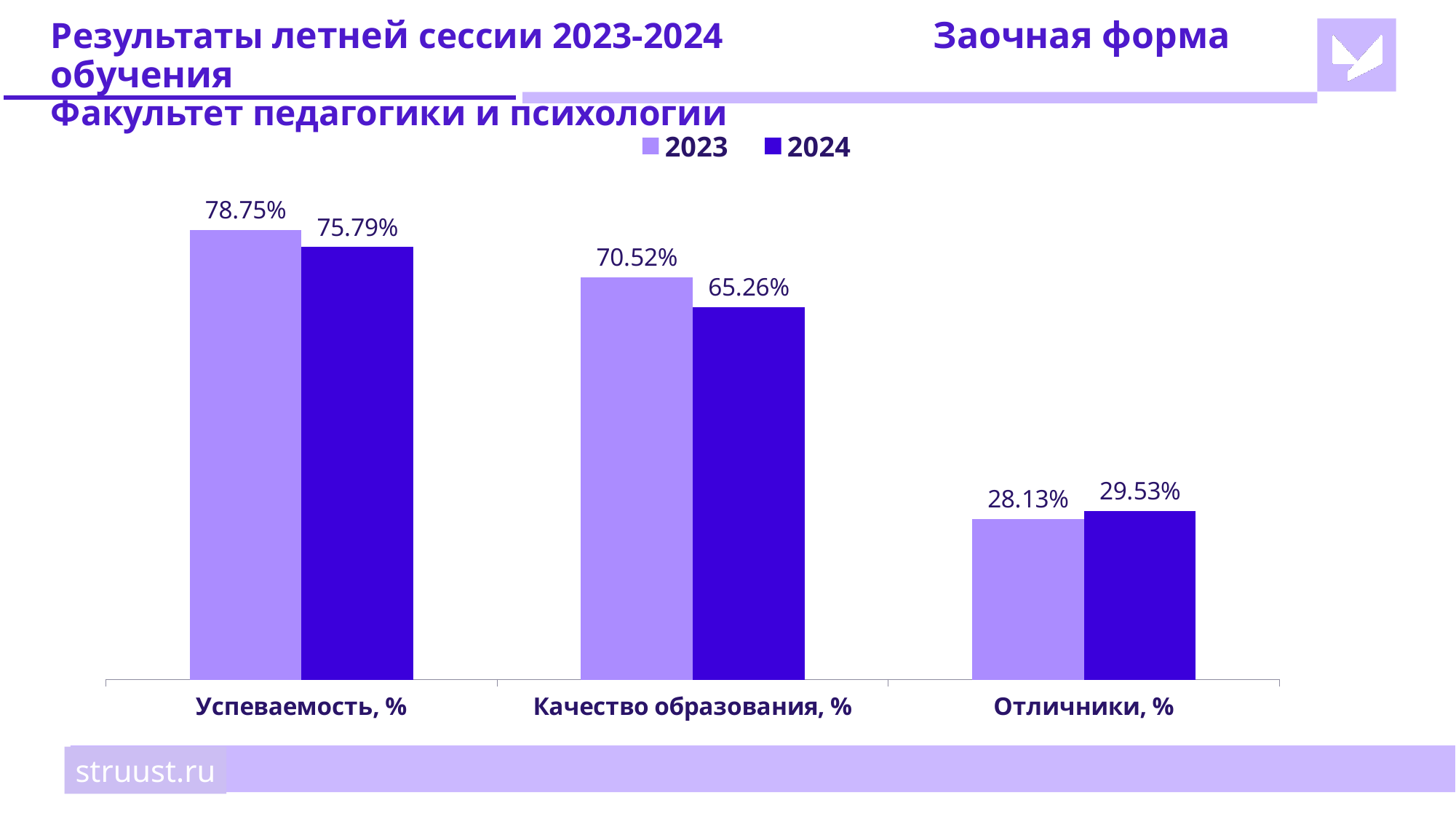
What is the value for 2023 in the Качество образования, % category? 70.52% What kind of chart is shown on the slide? Bar chart Which is larger for Отличники, %: the 2023 value or the 2024 value? 2024 Which series is shown in the darker purple colour? 2024 What is the value for 2024 in the Отличники, % category? 29.53% What is the value for 2023 in the Успеваемость, % category? 78.75% Which category has the highest value for 2024? Успеваемость, % What is the difference between the 2023 and 2024 values for Качество образования, %? 5.26% What is the value for 2024 in the Качество образования, % category? 65.26% How many series does the legend list? 2 Which category has the lowest value for 2023? Отличники, % How many categories are shown on the x axis? 3